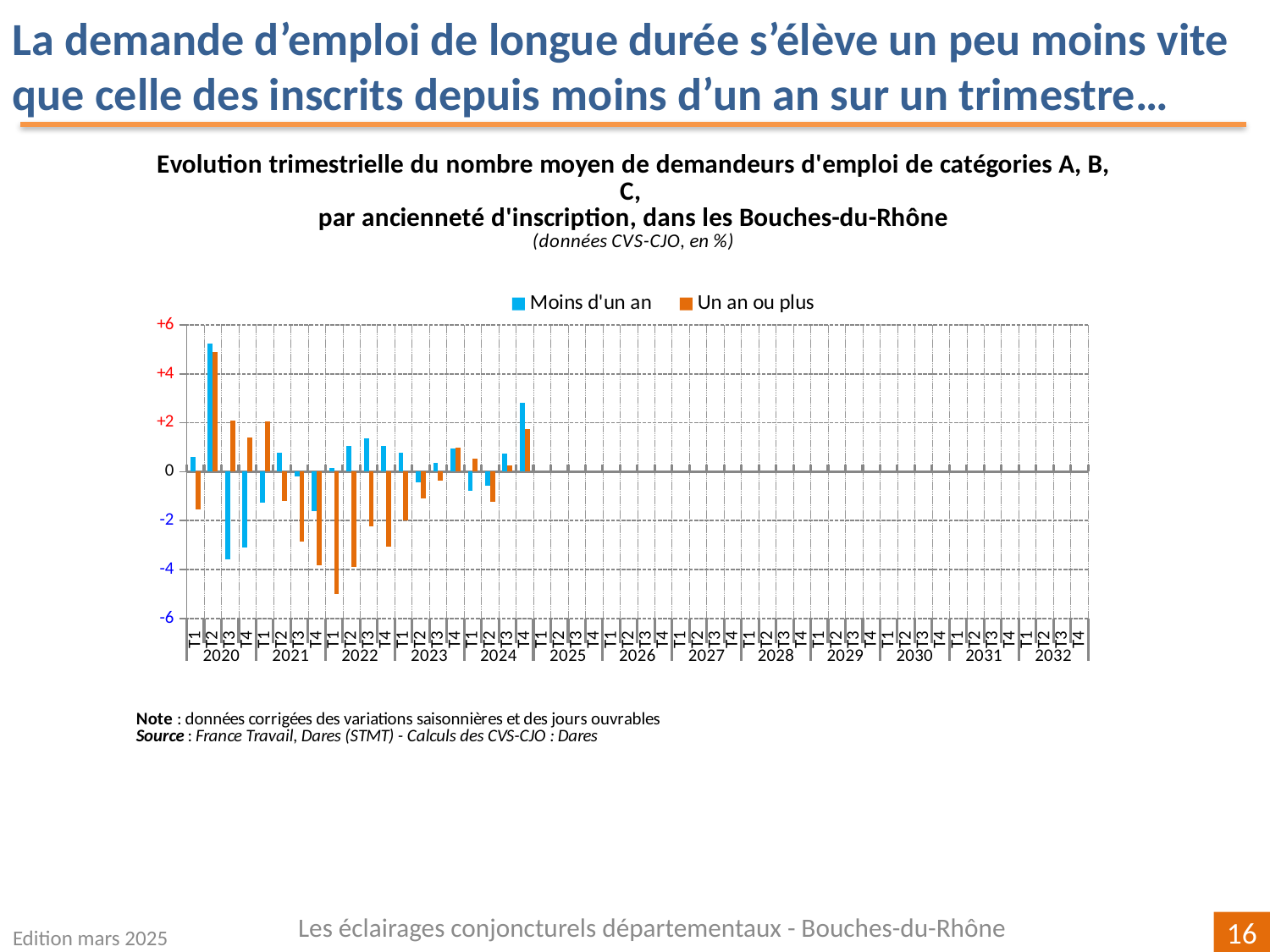
Is the value for 'Moins d'un an' in T2 2020 greater or less than +4? greater What are the two series named in the legend? Moins d'un an; Un an ou plus How many years are labelled on the x axis? 13 Is the value for 'Un an ou plus' in T1 2022 greater or less than -4? less What kind of chart is shown on the slide? Bar chart How many series does the legend list? 2 In which quarter does the series 'Moins d'un an' reach its highest value? T2 2020 Is the value for 'Moins d'un an' in T3 2020 greater or less than -2? less In which quarter does the series 'Un an ou plus' reach its lowest value? T1 2022 In T1 2022, which series has the larger value, 'Moins d'un an' or 'Un an ou plus'? Moins d'un an Which colour represents the series 'Moins d'un an'? Blue